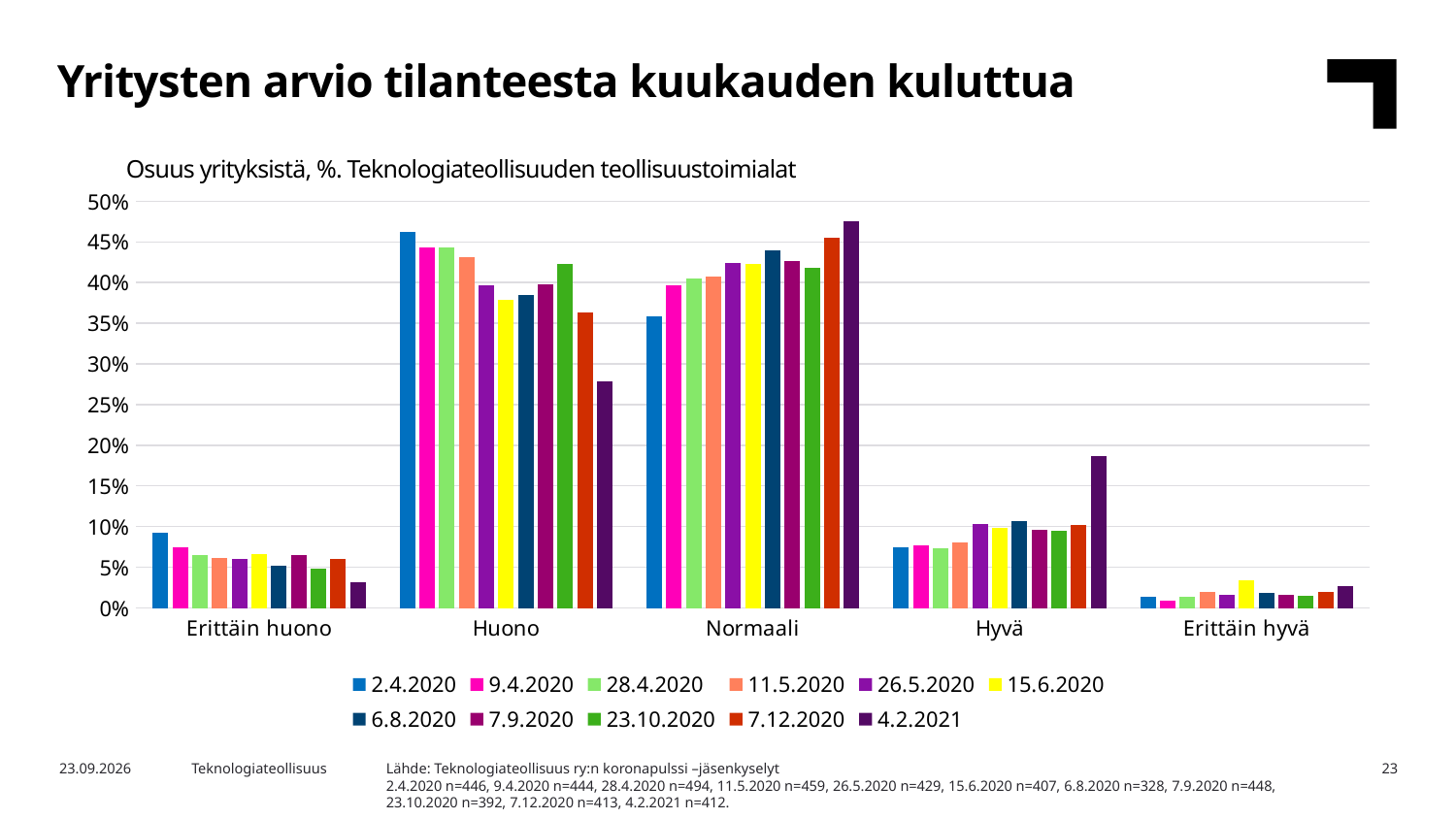
Is the value for 4.2.2021 in the Hyvä category greater or less than 15%? greater How many series does the legend list? 11 Is the value for 2.4.2020 in the Normaali category greater or less than 40%? less In the Normaali category, which series has the highest bar? 4.2.2021 What kind of chart is shown on the slide? bar chart How many categories are shown on the x axis? 5 In the Hyvä category, which series has the highest bar? 4.2.2021 What is the subtitle shown above the chart? Osuus yrityksistä, %. Teknologiateollisuuden teollisuustoimialat Is the value for 4.2.2021 in the Huono category greater or less than 30%? less For the 4.2.2021 series, which is larger: the Normaali bar or the Huono bar? Normaali In the Huono category, which series has the lowest bar? 4.2.2021 In the Huono category, which series has the highest bar? 2.4.2020